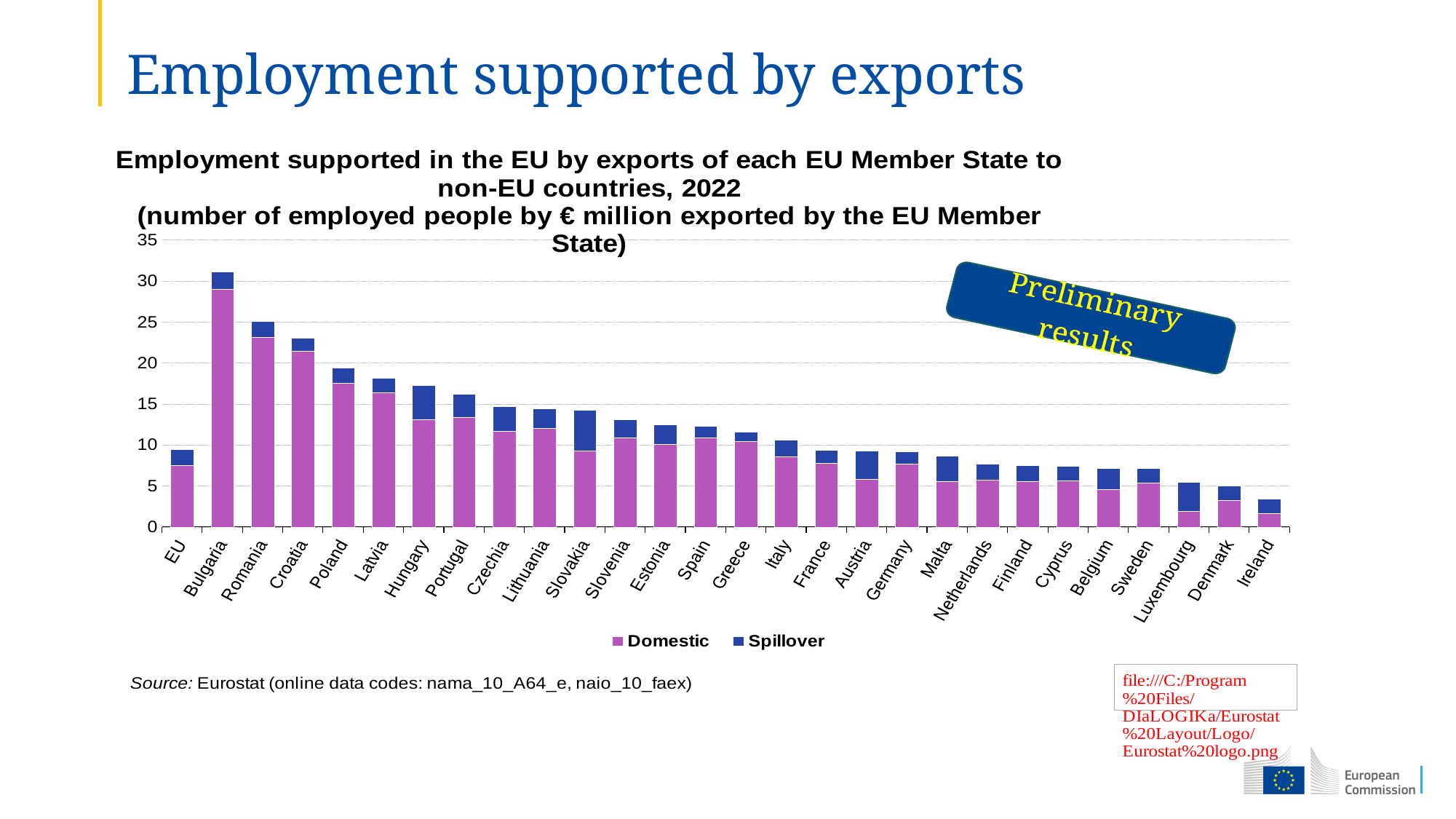
Do the total bar values generally rise or fall moving from Bulgaria to Ireland along the x axis? fall How many categories are shown on the x axis? 28 Is the total value for Bulgaria greater or less than 25? greater Is the total value for Germany greater or less than 10? less Is the total value for Ireland greater or less than 5? less What kind of chart is shown on the slide? Stacked bar chart How many series does the legend list? 2 Which has the larger total bar, Croatia or Poland? Croatia Which category has the highest total bar? Bulgaria What are the two series named in the legend? Domestic and Spillover Which category has the lowest total bar? Ireland